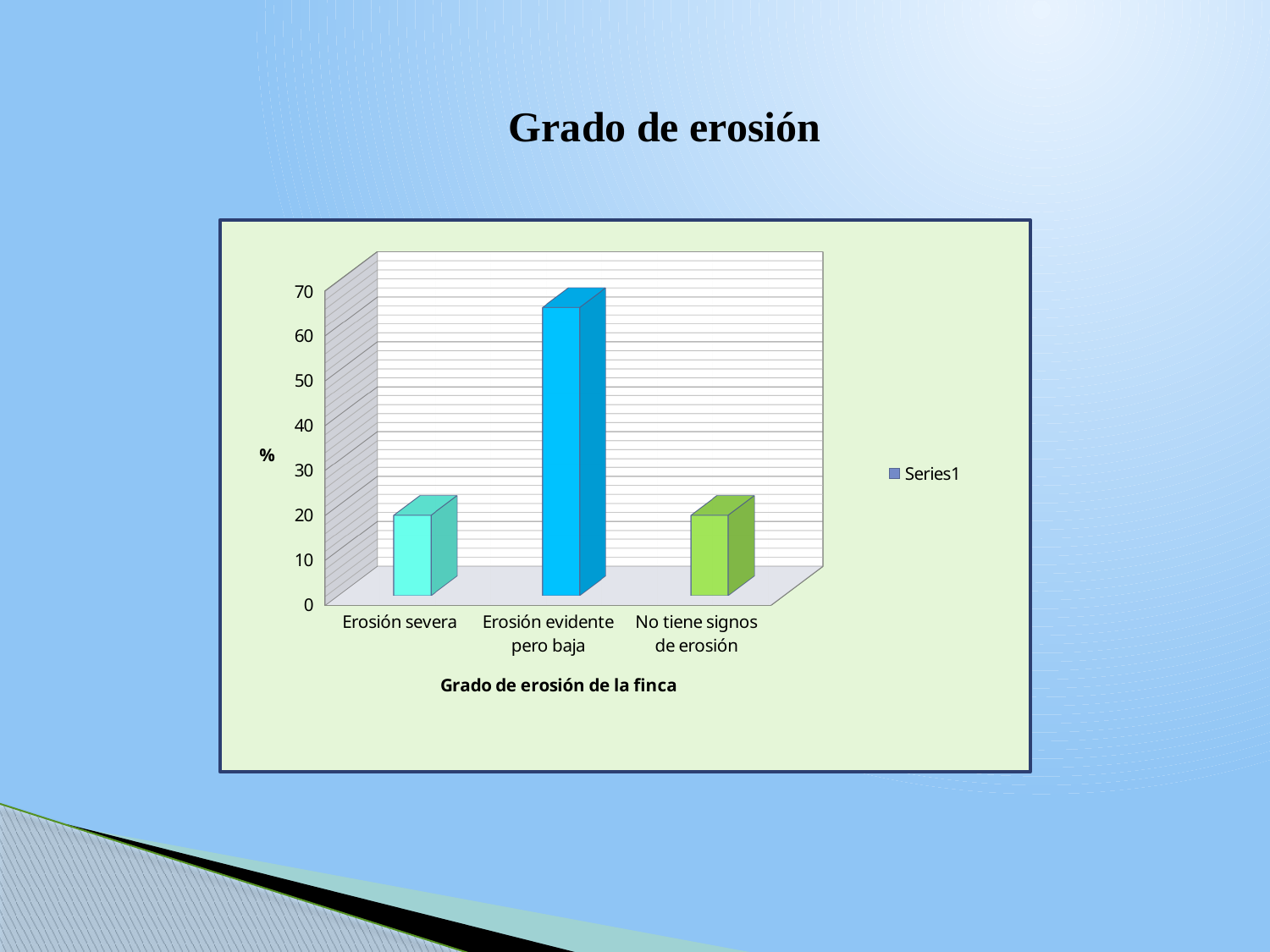
What label is shown on the chart's vertical axis? % Is the value for No tiene signos de erosión greater or less than 40? less How many categories are shown on the x axis of the chart? 3 Which is larger, the value for No tiene signos de erosión or the value for Erosión evidente pero baja? Erosión evidente pero baja What is the title of the chart's x axis? Grado de erosión de la finca Is the value for Erosión severa greater or less than 10? greater Which category has the highest value in the chart? Erosión evidente pero baja Is the value for Erosión severa greater or less than 30? less What kind of chart is shown on the slide? bar chart Which is larger, the value for Erosión evidente pero baja or the value for Erosión severa? Erosión evidente pero baja How many series does the chart legend list? 1